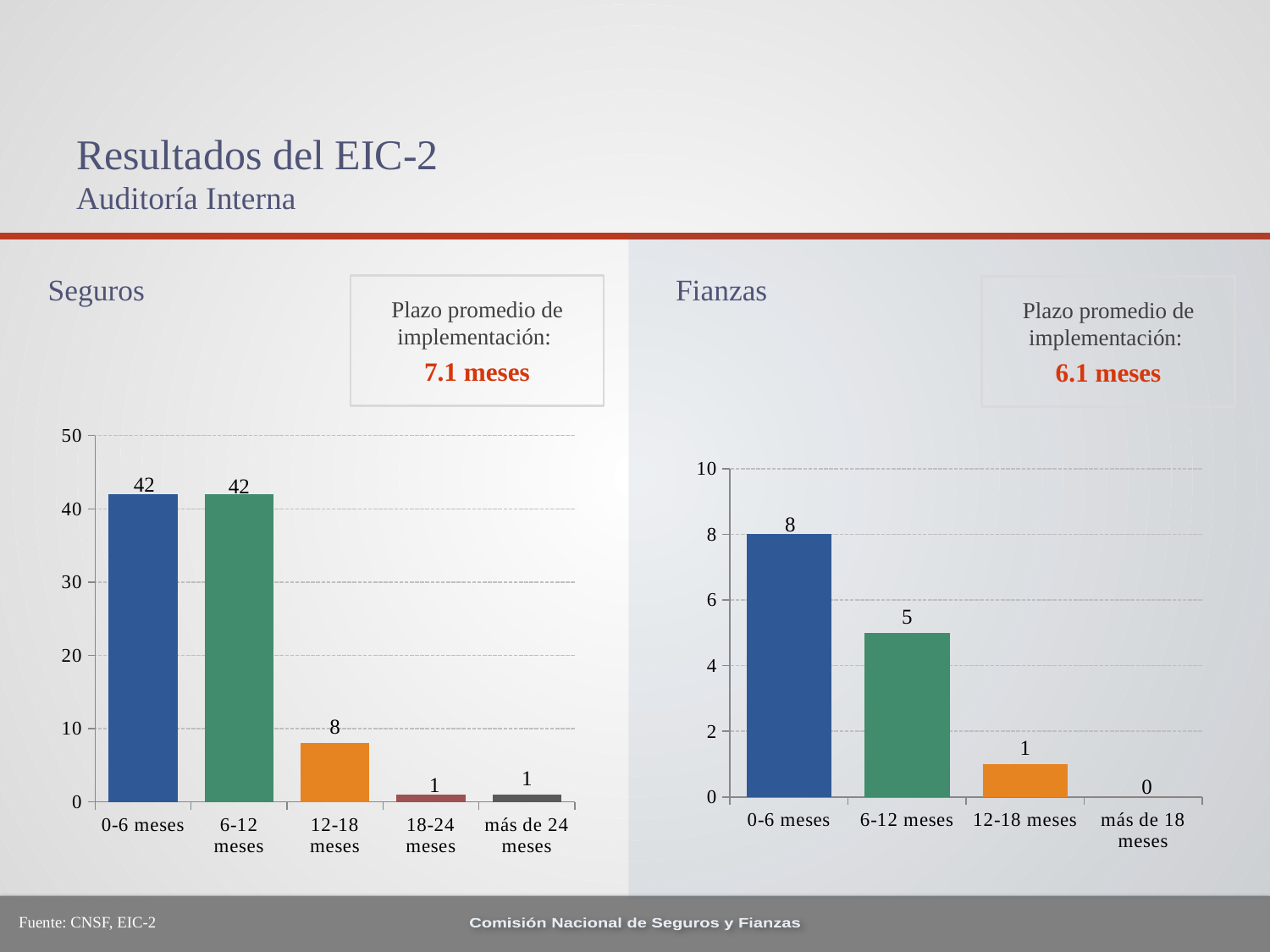
How many categories does the Seguros chart show? 5 In the Fianzas chart, do the values rise or fall from left to right along the x axis? fall What kind of chart is the Fianzas chart? bar chart How many categories does the Fianzas chart show? 4 In the Fianzas chart, what is the difference between the values for 0-6 meses and 12-18 meses? 7 In the Seguros chart, which is larger: the value for 12-18 meses or the value for 18-24 meses? 12-18 meses In the Seguros chart, what is the value for 12-18 meses? 8 In the Fianzas chart, which category has the lowest value? más de 18 meses In the Seguros chart, is the value for 0-6 meses greater or less than 40? greater In the Fianzas chart, which category has the highest value? 0-6 meses In the Fianzas chart, what is the value for 6-12 meses? 5 In the Seguros chart, what is the difference between the values for 6-12 meses and 12-18 meses? 34